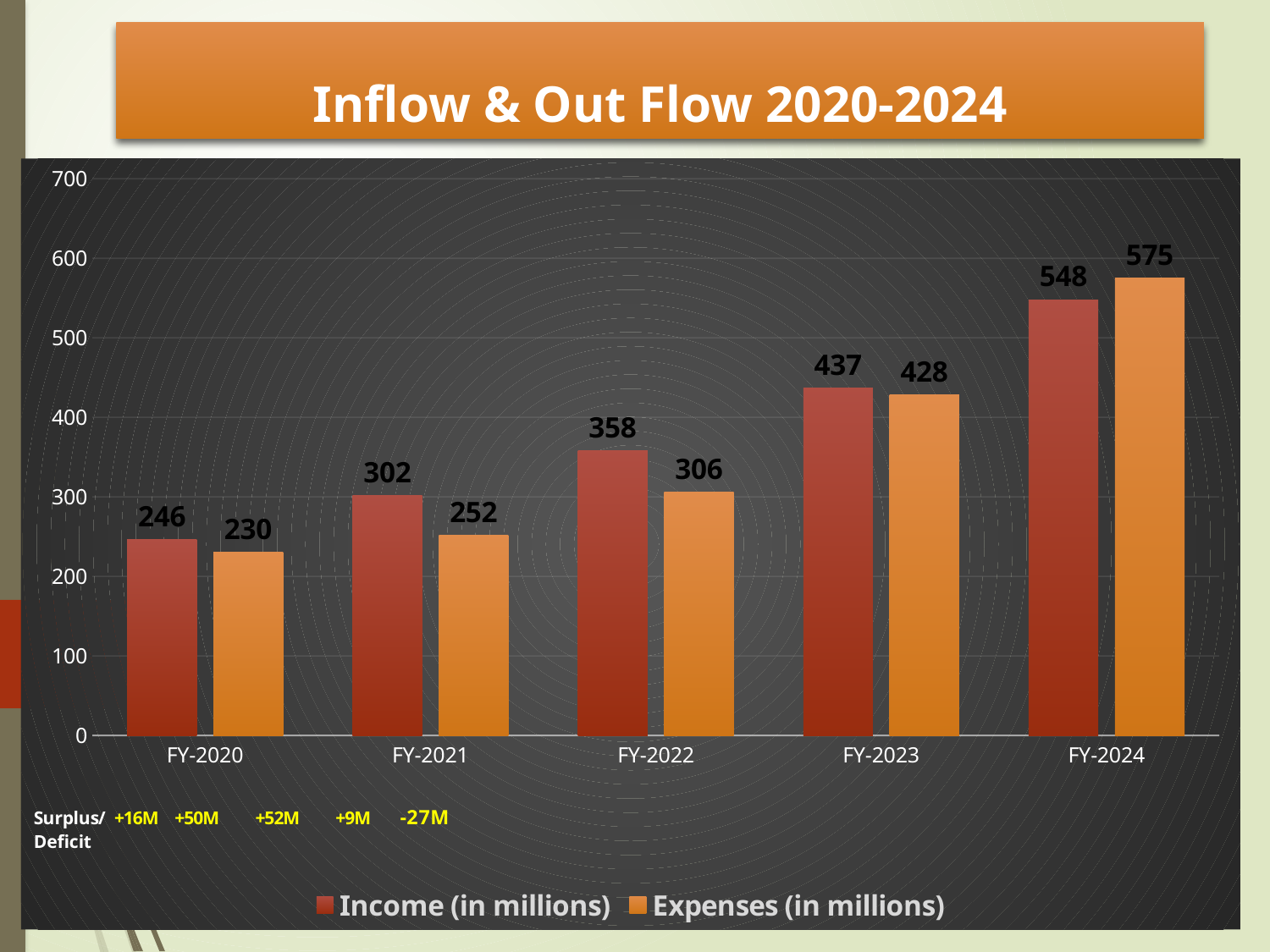
What is the Income (in millions) value for FY-2022? 358 Is the Income value for FY-2023 greater or less than 400? greater Which fiscal year has the highest Income (in millions)? FY-2024 What is the Expenses (in millions) value for FY-2020? 230 In FY-2024, which is larger, Income or Expenses? Expenses How many fiscal years are shown on the x axis? 5 What is the difference between Income and Expenses in FY-2021? 50 Which fiscal year has the lowest Expenses (in millions)? FY-2020 How many series does the legend list? 2 Do the Income values rise or fall from FY-2020 to FY-2024? rise What is the Expenses (in millions) value for FY-2024? 575 What kind of chart is shown on the slide? bar chart